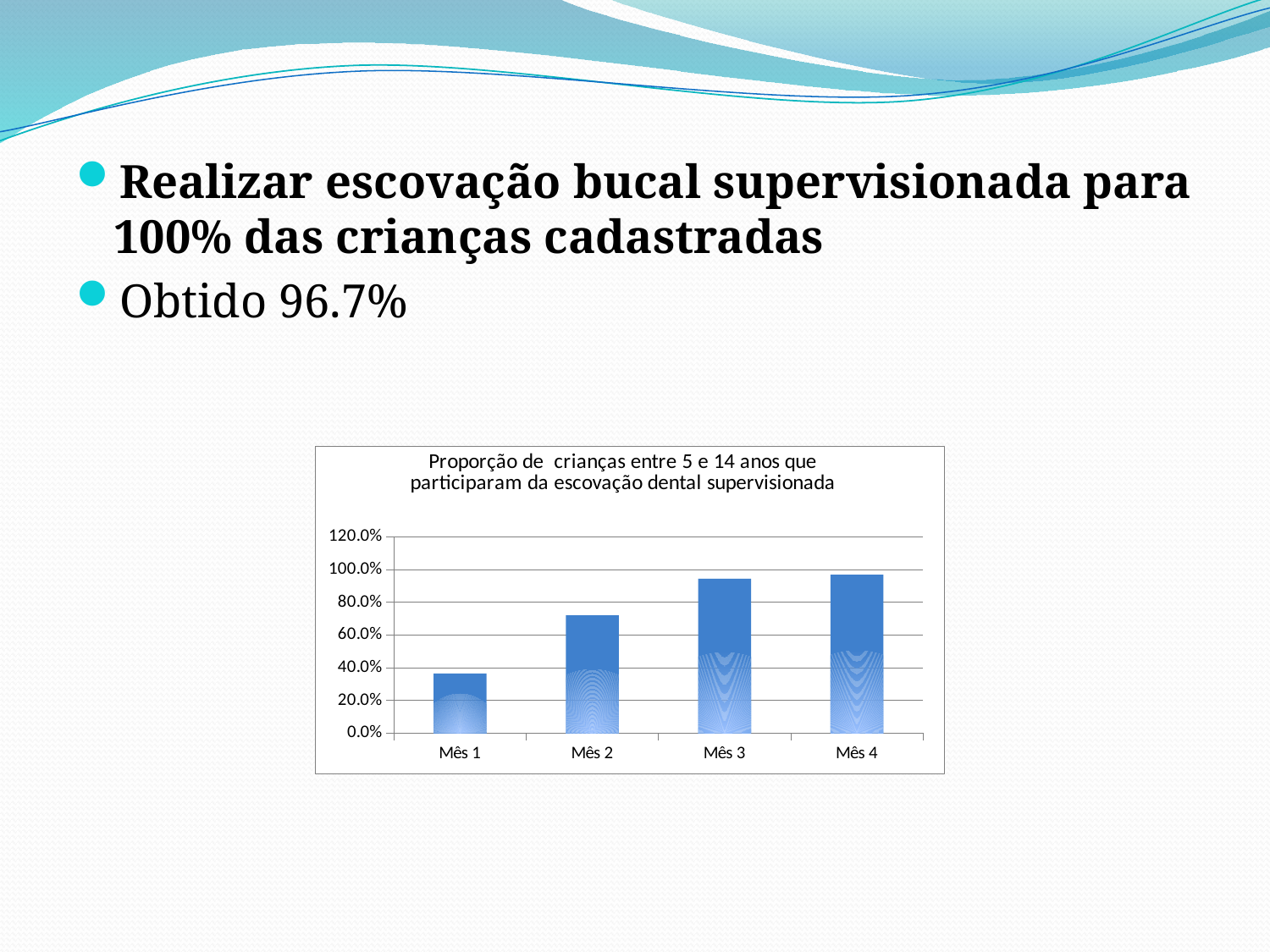
Is the value for Mês 4 greater or less than 100.0%? less Is the value for Mês 1 greater or less than 20.0%? greater Which is larger, the value for Mês 1 or the value for Mês 2? Mês 2 Is the value for Mês 2 greater or less than 60.0%? greater Which is larger, the value for Mês 2 or the value for Mês 3? Mês 3 What is the title of the chart? Proporção de crianças entre 5 e 14 anos que participaram da escovação dental supervisionada How many categories (months) are plotted on the chart? 4 Do the values rise or fall from Mês 1 to Mês 4? rise Which month has the lowest proportion of children participating in supervised brushing? Mês 1 What kind of chart is shown on the slide? bar chart